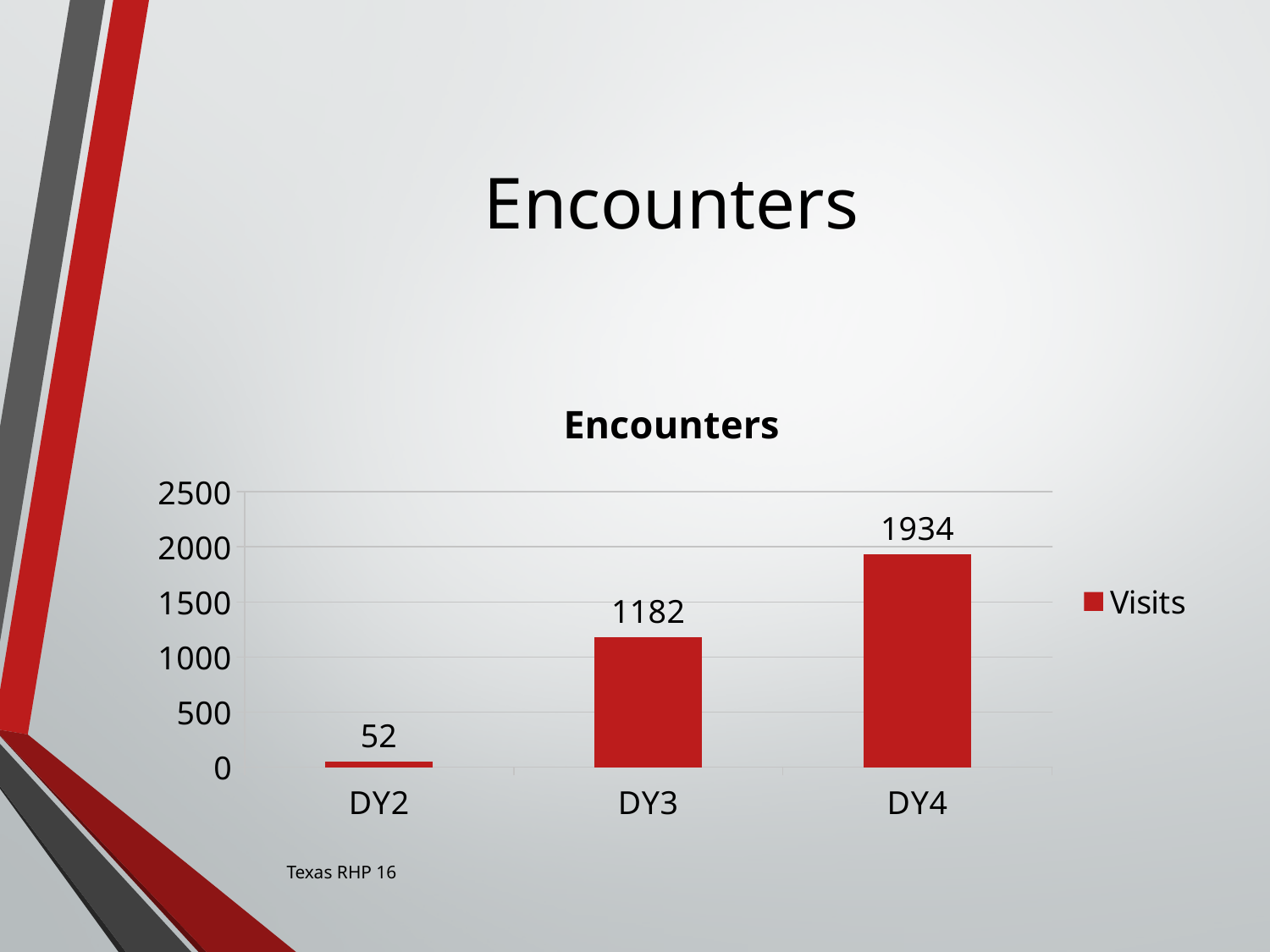
How many categories are shown on the x axis? 3 What is the value for DY3? 1182 Which category has the lowest value? DY2 What is the value for DY2? 52 What is the difference between the values for DY3 and DY2? 1130 Is the value for DY4 greater or less than 1500? greater Which is larger, the value for DY3 or the value for DY4? DY4 What kind of chart is shown? bar chart Do the values rise or fall from DY2 to DY4? rise Which category has the highest value? DY4 What is the value for DY4? 1934 What is the difference between the values for DY4 and DY3? 752